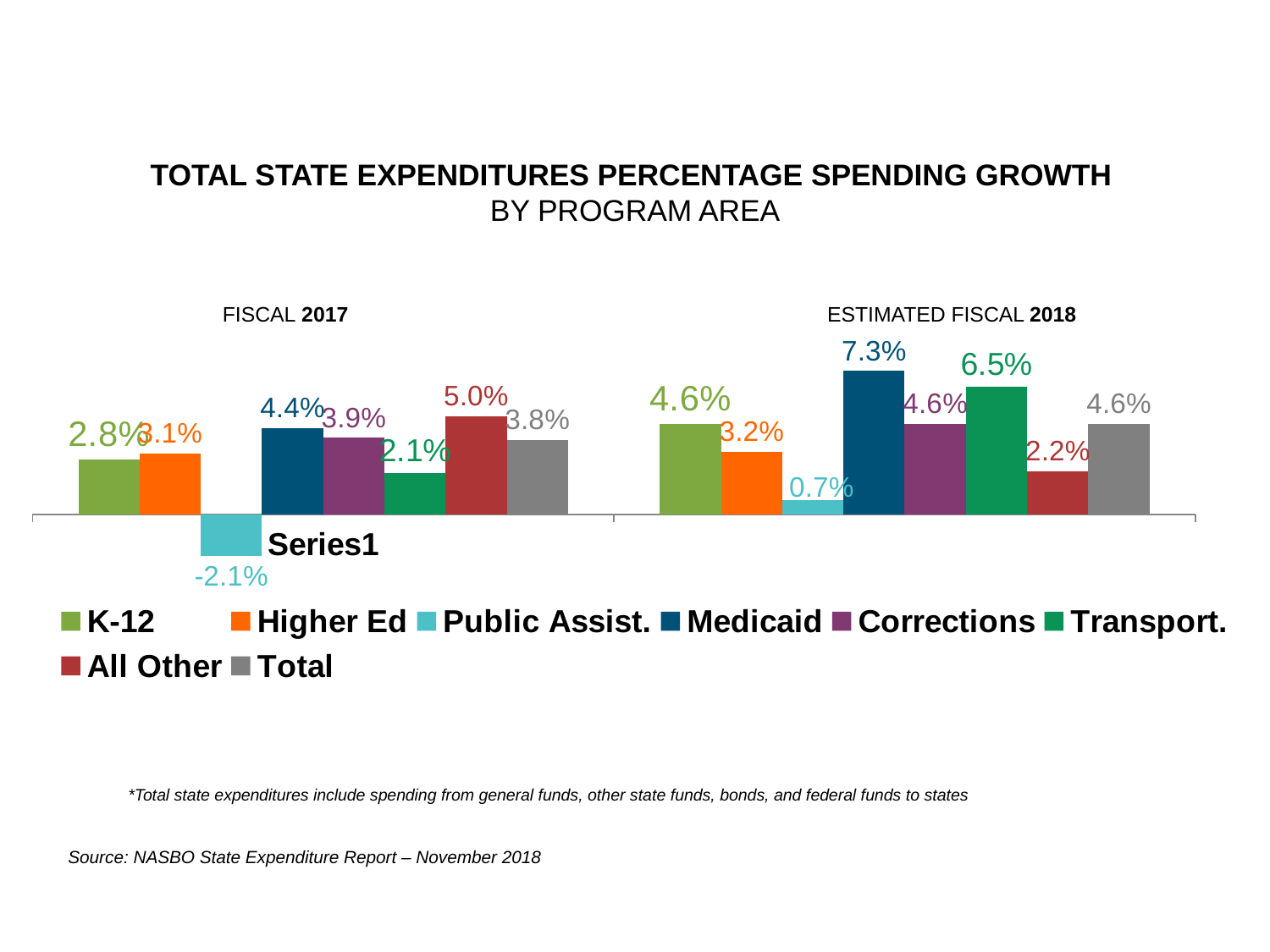
How many series does the legend list? 8 What is the percentage spending growth for Public Assist. in Fiscal 2017? -2.1% What is the Total percentage spending growth in Estimated Fiscal 2018? 4.6% Which is larger in Fiscal 2017: the spending growth for Medicaid or for Corrections? Medicaid What is the difference between the Medicaid spending growth in Estimated Fiscal 2018 and in Fiscal 2017? 2.9% Which program area has the highest spending growth in Fiscal 2017? All Other What is the percentage spending growth for All Other in Fiscal 2017? 5.0% Which program area has the lowest spending growth in Fiscal 2017? Public Assist. Which program area has the highest spending growth in Estimated Fiscal 2018? Medicaid What is the difference between the Transport. spending growth in Estimated Fiscal 2018 and in Fiscal 2017? 4.4% What kind of chart is shown on the slide? Bar chart What is the percentage spending growth for Medicaid in Estimated Fiscal 2018? 7.3%